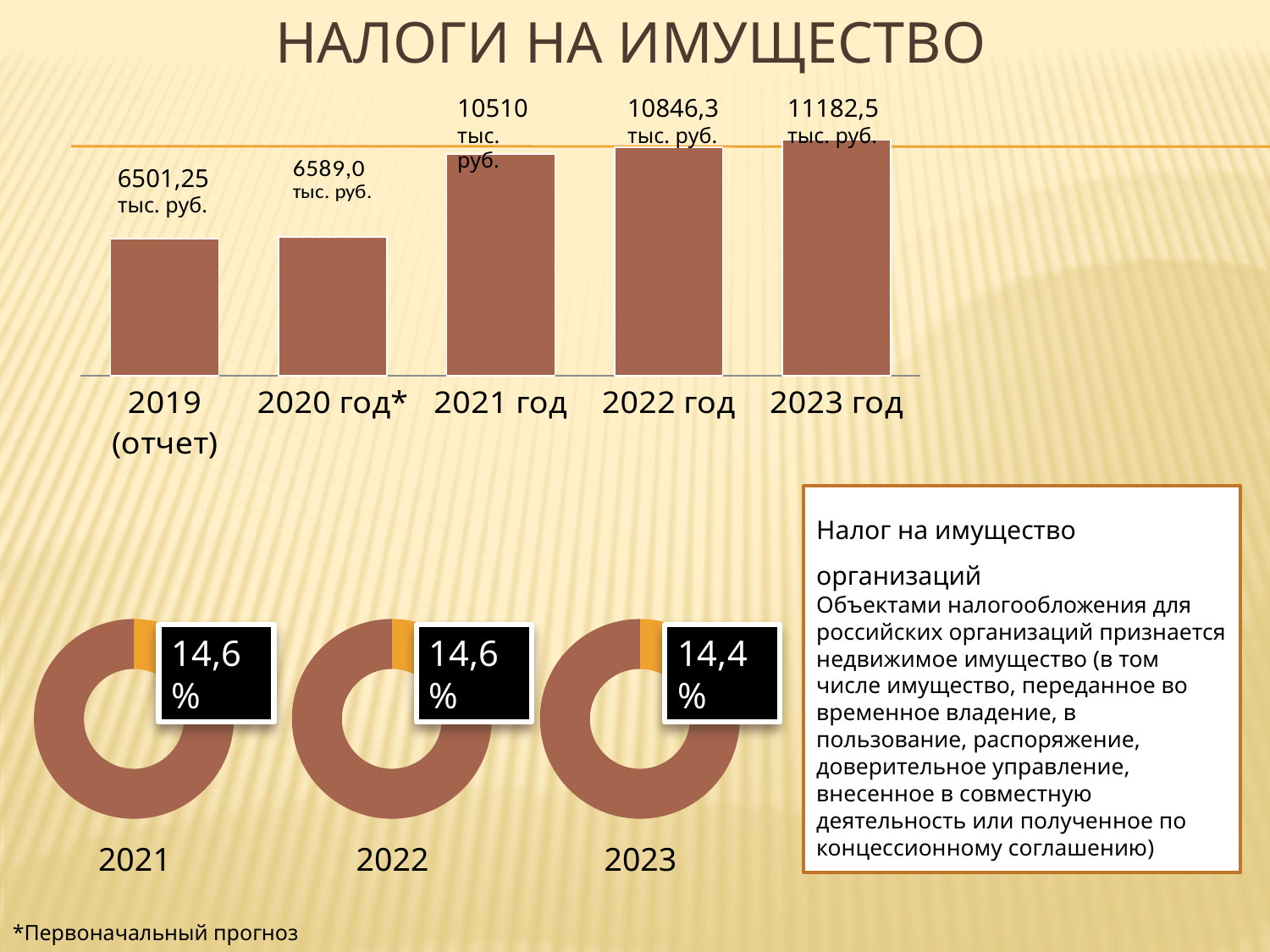
Do the values in the bar chart rise or fall from 2019 to 2023? rise In the bar chart, which year has the lowest value? 2019 (отчет) In the bar chart, what is the value for 2023 год? 11182,5 тыс. руб. In the bar chart, what is the value for 2019 (отчет)? 6501,25 тыс. руб. In the bar chart, what is the value for 2021 год? 10510 тыс. руб. In the bar chart, what is the difference between the values for 2021 год and 2020 год*? 3921,0 тыс. руб. How many bars are in the bar chart? 5 In the donut chart for 2021, what share is shown by the highlighted slice? 14,6% In the bar chart, what is the difference between the values for 2023 год and 2022 год? 336,2 тыс. руб. In the bar chart, which year has the highest value? 2023 год In the bar chart, which is larger: the value for 2022 год or the value for 2020 год*? 2022 год In the donut chart for 2023, what share is shown by the highlighted slice? 14,4%